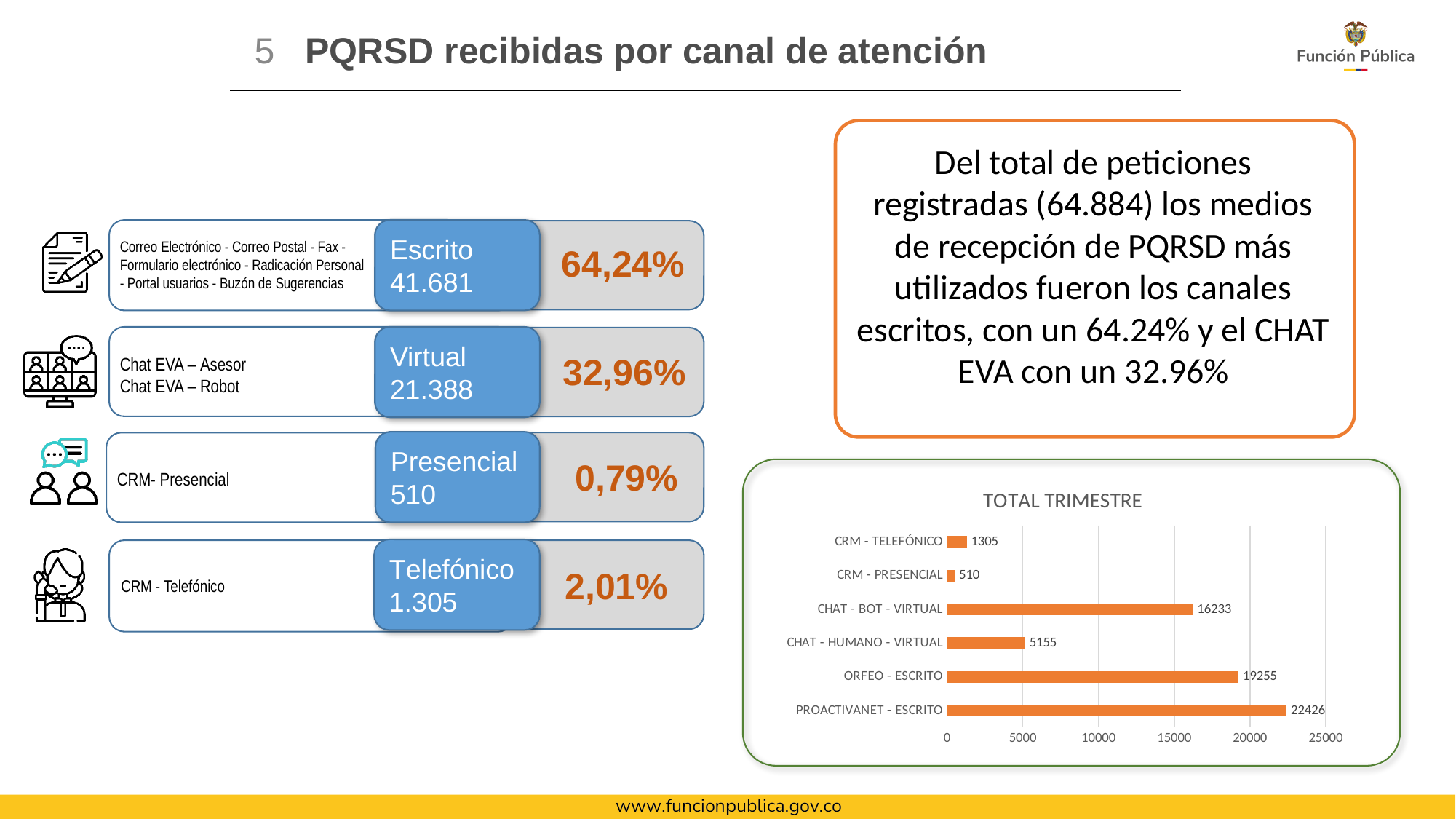
What is the value for CRM - PRESENCIAL in the TOTAL TRIMESTRE chart? 510 Which category has the highest value in the TOTAL TRIMESTRE chart? PROACTIVANET - ESCRITO What is the value for PROACTIVANET - ESCRITO in the TOTAL TRIMESTRE chart? 22426 What kind of chart is the TOTAL TRIMESTRE chart? bar chart What is the maximum value shown on the x axis of the TOTAL TRIMESTRE chart? 25000 What is the difference between ORFEO - ESCRITO and CHAT - HUMANO - VIRTUAL in the TOTAL TRIMESTRE chart? 14100 How many categories are shown in the TOTAL TRIMESTRE chart? 6 What is the value for CHAT - BOT - VIRTUAL in the TOTAL TRIMESTRE chart? 16233 Which category has the lowest value in the TOTAL TRIMESTRE chart? CRM - PRESENCIAL In the TOTAL TRIMESTRE chart, which is larger: ORFEO - ESCRITO or CHAT - BOT - VIRTUAL? ORFEO - ESCRITO In the TOTAL TRIMESTRE chart, is the value for CHAT - HUMANO - VIRTUAL greater or less than 10000? less What is the title of the chart on the slide? TOTAL TRIMESTRE